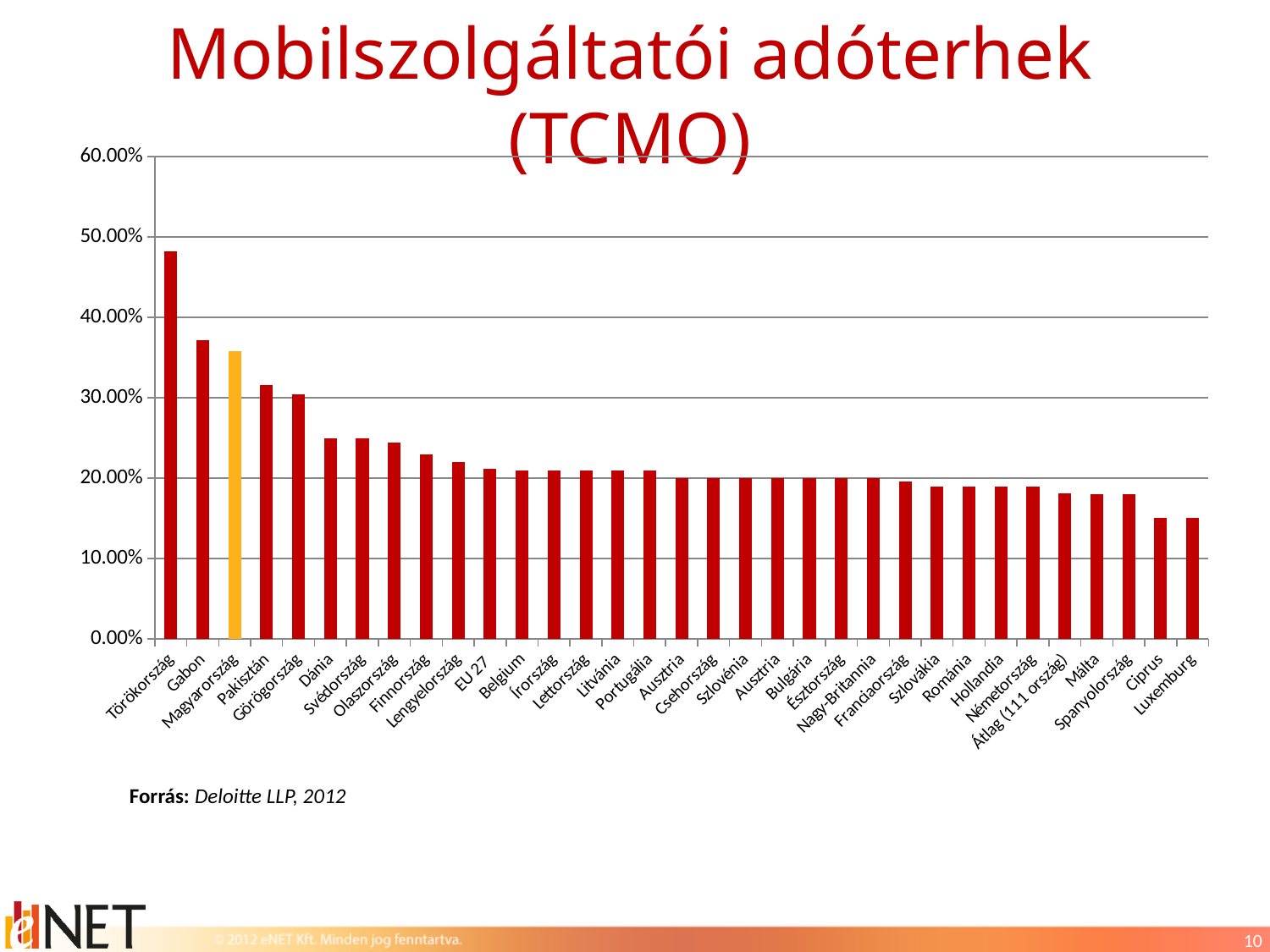
Is the value for Magyarország greater or less than 30.00%? greater What is the title of the chart? Mobilszolgáltatói adóterhek (TCMO) Which bar is highlighted in a different colour (orange) from the others? Magyarország Is the value for Luxemburg greater or less than 20.00%? less Which has a larger value, Magyarország or Pakisztán? Magyarország Is the value for Törökország greater or less than 40.00%? greater What kind of chart is shown on the slide? bar chart Do the values generally rise or fall from left to right along the x axis? fall Which country has the highest value in the chart? Törökország Which has a larger value, Törökország or Gabon? Törökország